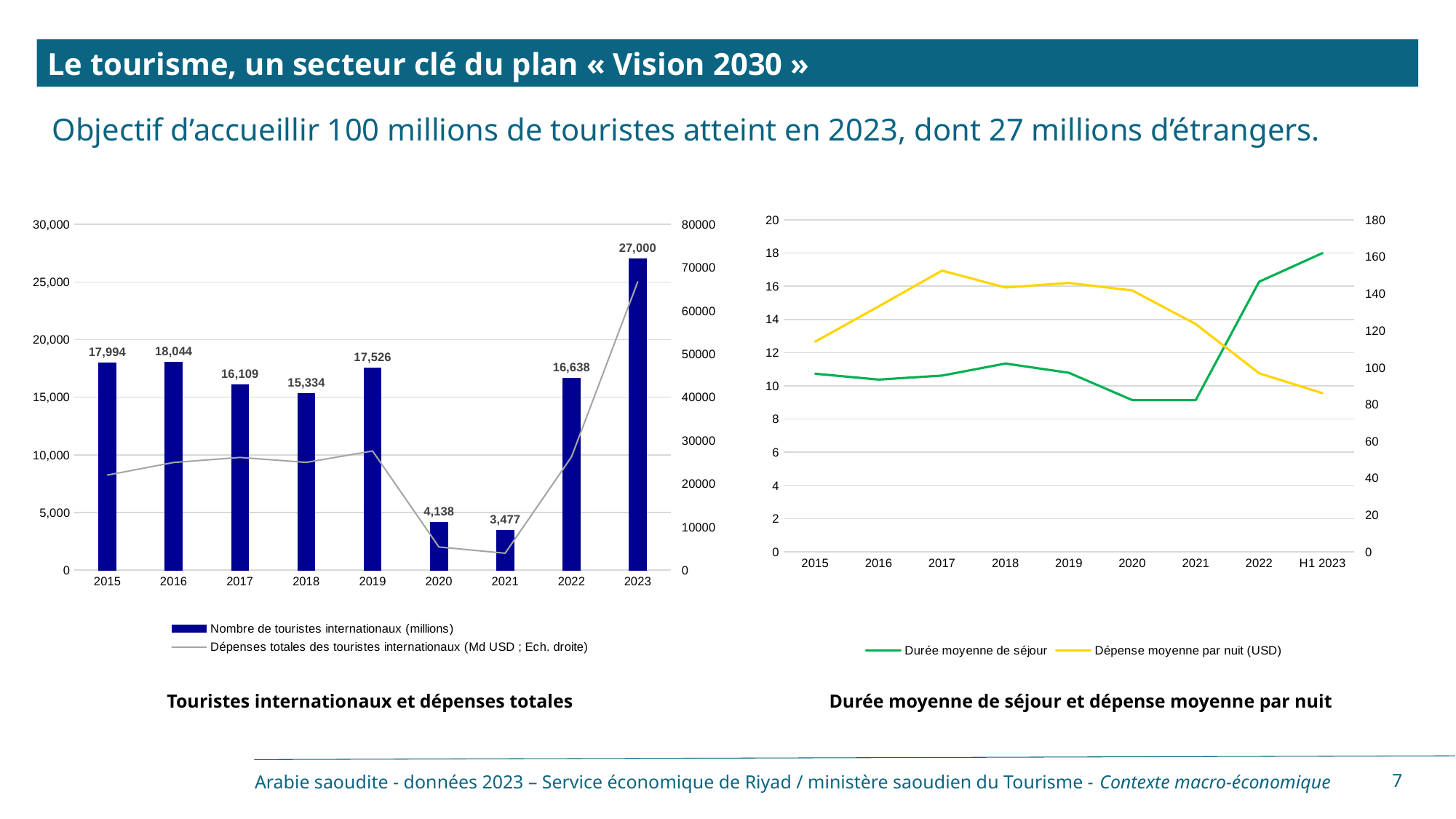
In the chart 'Durée moyenne de séjour et dépense moyenne par nuit', does 'Dépense moyenne par nuit (USD)' rise or fall between 2019 and H1 2023? fall In the chart 'Touristes internationaux et dépenses totales', which bar is larger, 2017 or 2018? 2017 In the chart 'Durée moyenne de séjour et dépense moyenne par nuit', is the value of 'Durée moyenne de séjour' in 2021 greater or less than 10? less In the chart 'Touristes internationaux et dépenses totales', how many years are shown on the x axis? 9 In the chart 'Durée moyenne de séjour et dépense moyenne par nuit', is the value of 'Dépense moyenne par nuit (USD)' in 2017 greater or less than 140? greater In the chart 'Touristes internationaux et dépenses totales', what is the difference between the bar values for 2023 and 2022? 10,362 In the chart 'Touristes internationaux et dépenses totales', what is the number of international tourists (millions) in 2023? 27,000 In the chart 'Touristes internationaux et dépenses totales', how many series does the legend list? 2 In the chart 'Touristes internationaux et dépenses totales', which year has the lowest bar? 2021 In the chart 'Touristes internationaux et dépenses totales', what is the value of the bar for 2021? 3,477 In the chart 'Touristes internationaux et dépenses totales', which year has the highest bar? 2023 In the chart 'Durée moyenne de séjour et dépense moyenne par nuit', what colour is the line for 'Durée moyenne de séjour'? green